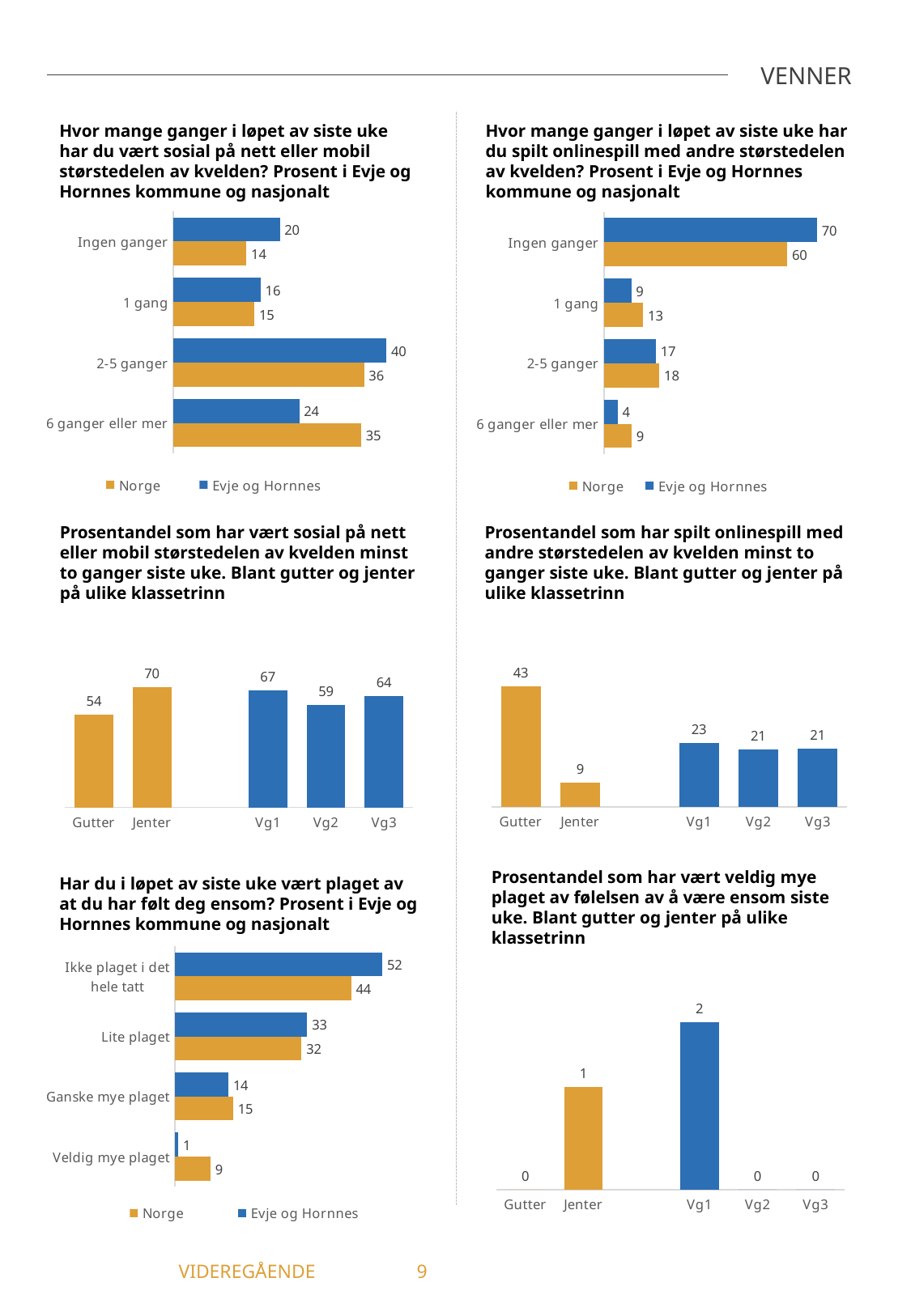
In the top-left chart about being social online or on mobile, what is the value for Evje og Hornnes for '2-5 ganger'? 40 In the middle-left chart about being social online at least twice last week, what is the value for Vg2? 59 In the middle-right chart about playing online games at least twice last week, how many categories are shown on the x axis? 5 In the bottom-left chart about feeling lonely, what is the value for Norge for 'Veldig mye plaget'? 9 In the top-right chart about playing online games, which category has the highest value for Evje og Hornnes? Ingen ganger What kind of chart is the bottom-right chart about being very bothered by loneliness? Bar chart In the top-right chart about playing online games, how many series does the legend list? 2 In the middle-right chart about playing online games at least twice last week, which is larger, Gutter or Jenter? Gutter In the top-right chart about playing online games, what is the value for Norge for '1 gang'? 13 In the top-left chart about being social online or on mobile, what is the difference between Norge and Evje og Hornnes for '6 ganger eller mer'? 11 In the bottom-left chart about feeling lonely, which category has the lowest value for Evje og Hornnes? Veldig mye plaget In the middle-left chart about being social online at least twice last week, which group has the highest value? Jenter